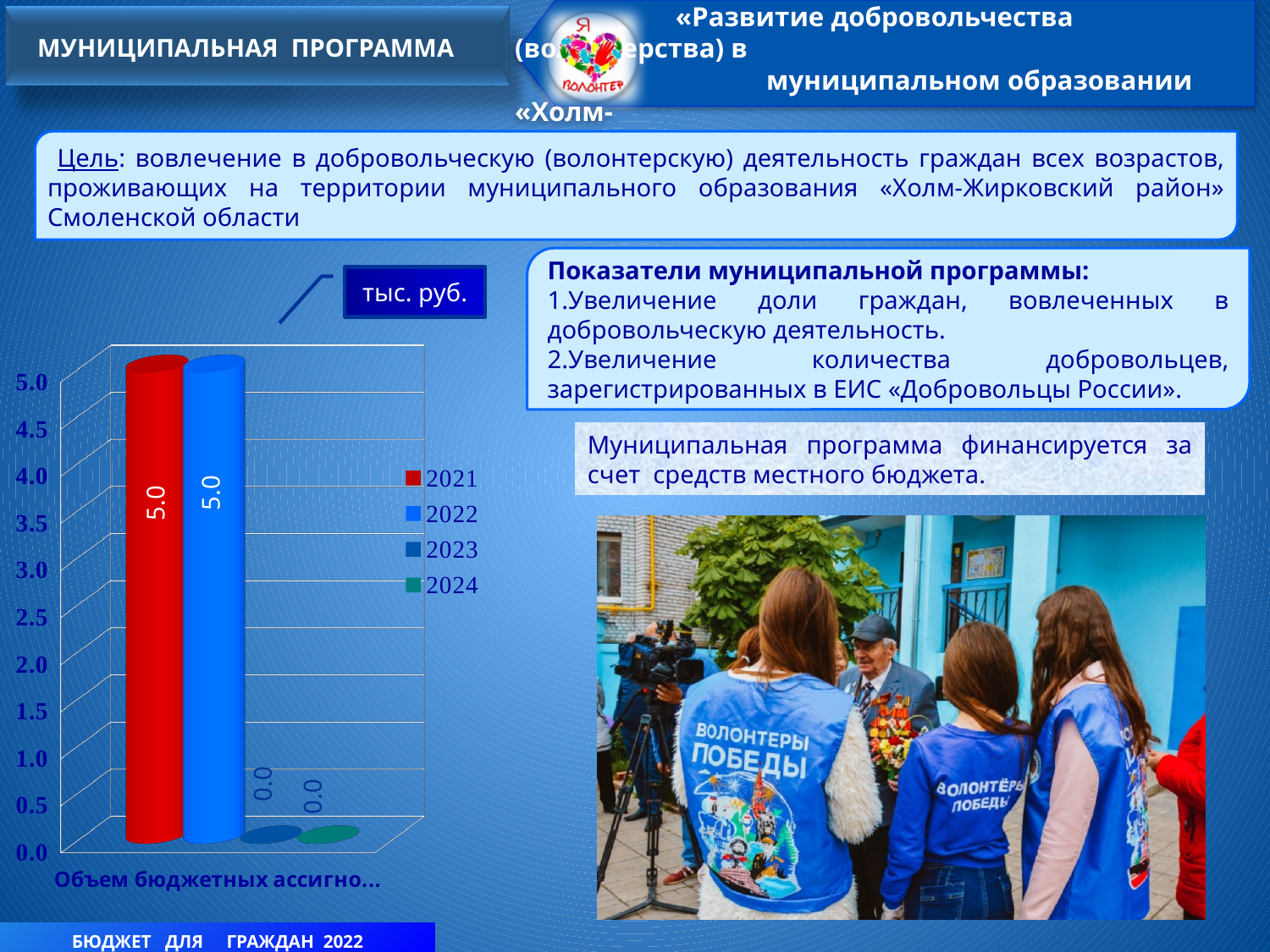
What is the value for 2023 in the chart? 0.0 What colour is the bar for 2021 in the chart? Red Is the value for 2022 greater or less than 4.0? greater What kind of chart is shown on the slide? Bar chart Is the value for 2023 greater or less than 1.0? less How many series does the chart legend list? 4 What is the difference between the value for 2022 and the value for 2024? 5.0 What is the value for 2024 in the chart? 0.0 What is the value for 2021 in the chart? 5.0 What unit is shown in the box above the chart? тыс. руб. What is the value for 2022 in the chart? 5.0 Which is larger, the value for 2021 or the value for 2023? 2021